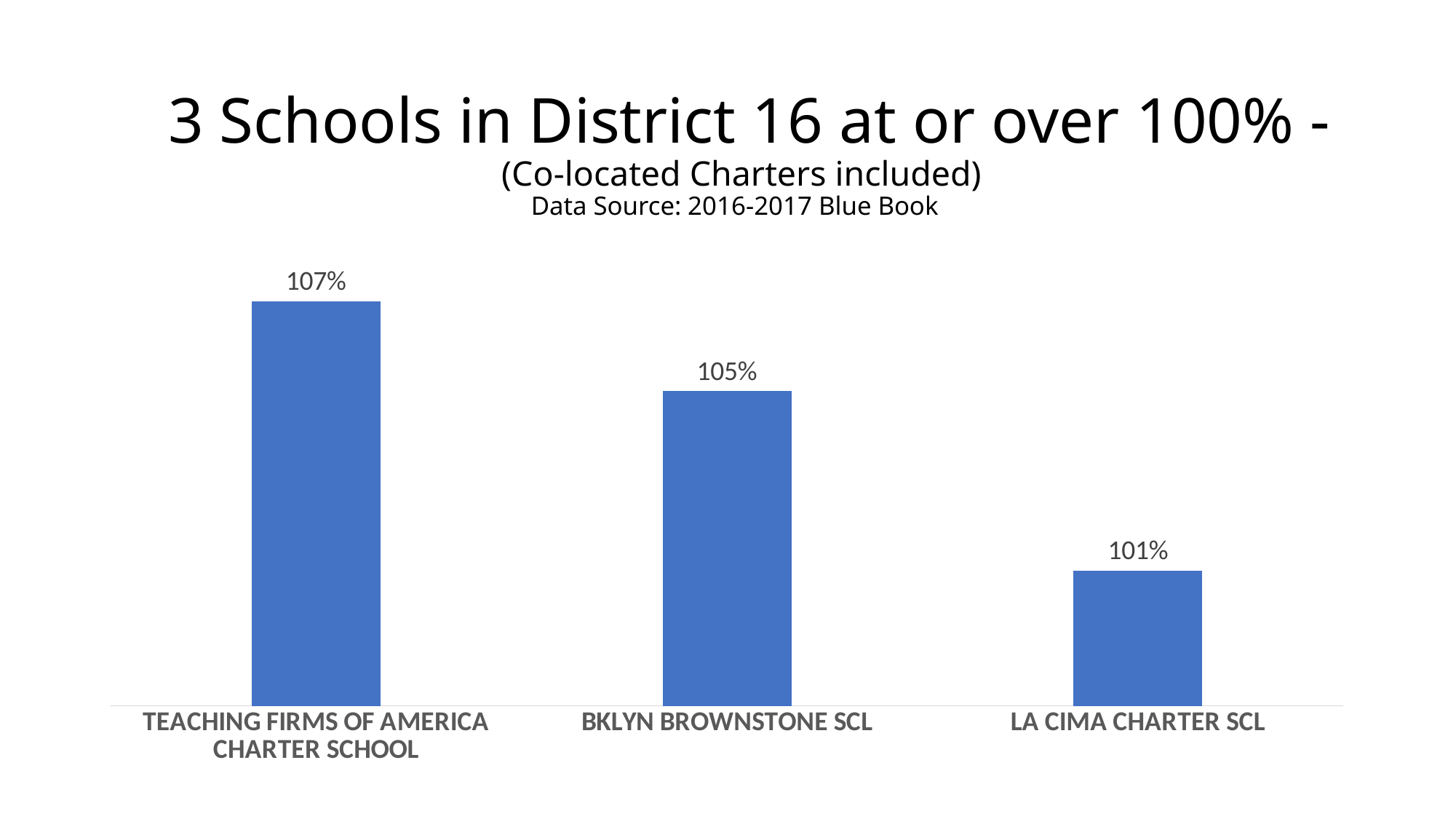
Which school has the highest value? Teaching Firms of America Charter School What data source is cited in the chart title? 2016-2017 Blue Book Which school has the lowest value? La Cima Charter Scl What is the value for Teaching Firms of America Charter School? 107% What is the value for Bklyn Brownstone Scl? 105% What is the value for La Cima Charter Scl? 101% Which is larger, the value for Bklyn Brownstone Scl or the value for La Cima Charter Scl? Bklyn Brownstone Scl What is the difference between the values for Teaching Firms of America Charter School and La Cima Charter Scl? 6% What is the difference between the values for Bklyn Brownstone Scl and La Cima Charter Scl? 4% What kind of chart is shown on the slide? Bar chart How many schools are shown in the chart? 3 Do the values rise or fall from left to right across the chart? Fall